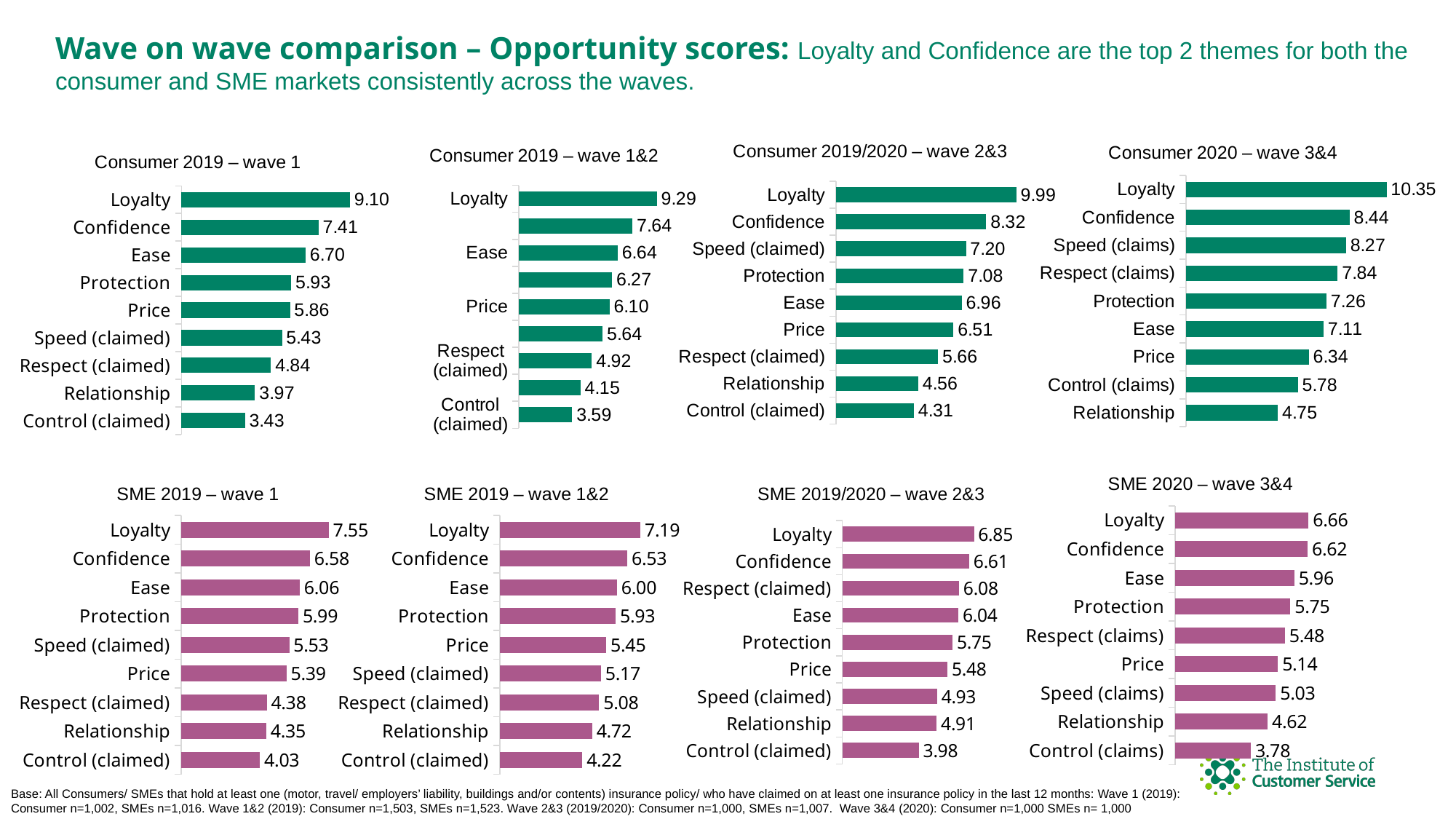
In the Consumer 2020 – wave 3&4 chart, which theme has the highest score? Loyalty In the SME 2019 – wave 1 chart, which theme has the lowest score? Control (claimed) In the Consumer 2019 – wave 1 chart, what is the opportunity score for Loyalty? 9.10 How many charts are shown on the slide? 8 What type of chart is the Consumer 2019 – wave 1 chart? Bar chart How many themes are shown in the SME 2019 – wave 1 chart? 9 In the SME 2019/2020 – wave 2&3 chart, what is the score for Respect (claimed)? 6.08 In the SME 2019 – wave 1&2 chart, what is the difference between the Loyalty and Control (claimed) scores? 2.97 In the SME 2020 – wave 3&4 chart, which is larger, the score for Ease or for Protection? Ease In the Consumer 2019/2020 – wave 2&3 chart, what is the difference between the Loyalty and Confidence scores? 1.67 In the Consumer 2019 – wave 1&2 chart, what is the score for Control (claimed)? 3.59 In the Consumer 2020 – wave 3&4 chart, what is the score for Relationship? 4.75